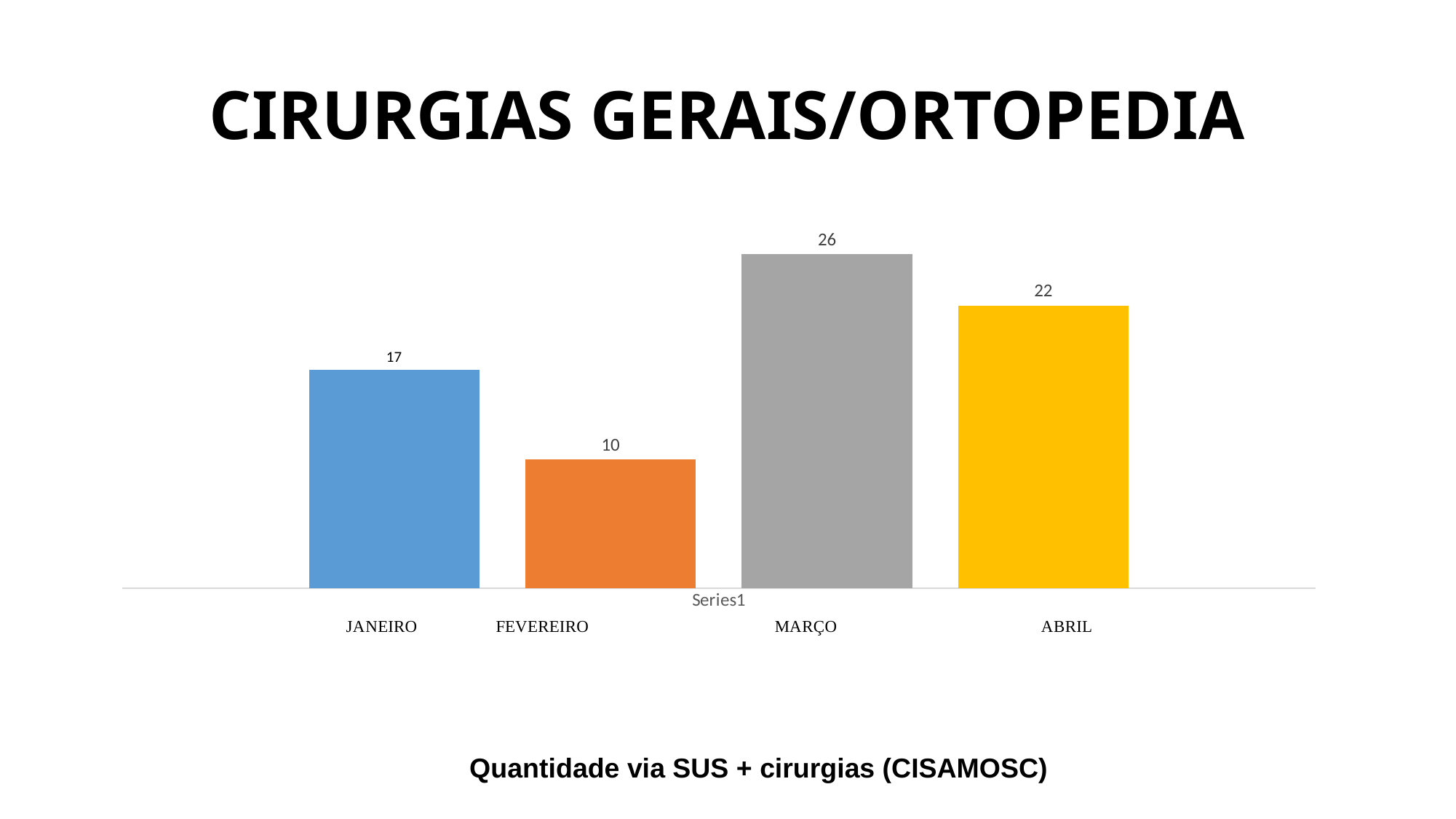
What is the title of the slide? CIRURGIAS GERAIS/ORTOPEDIA Which month has the highest value? MARÇO Which month has the lowest value? FEVEREIRO Which is larger, the value for JANEIRO or the value for ABRIL? ABRIL What is the value for JANEIRO? 17 What is the difference between the values for ABRIL and JANEIRO? 5 What is the value for FEVEREIRO? 10 What is the difference between the values for MARÇO and FEVEREIRO? 16 What kind of chart is shown on the slide? Bar chart What is the value for MARÇO? 26 How many months are shown in the chart? 4 What is the value for ABRIL? 22